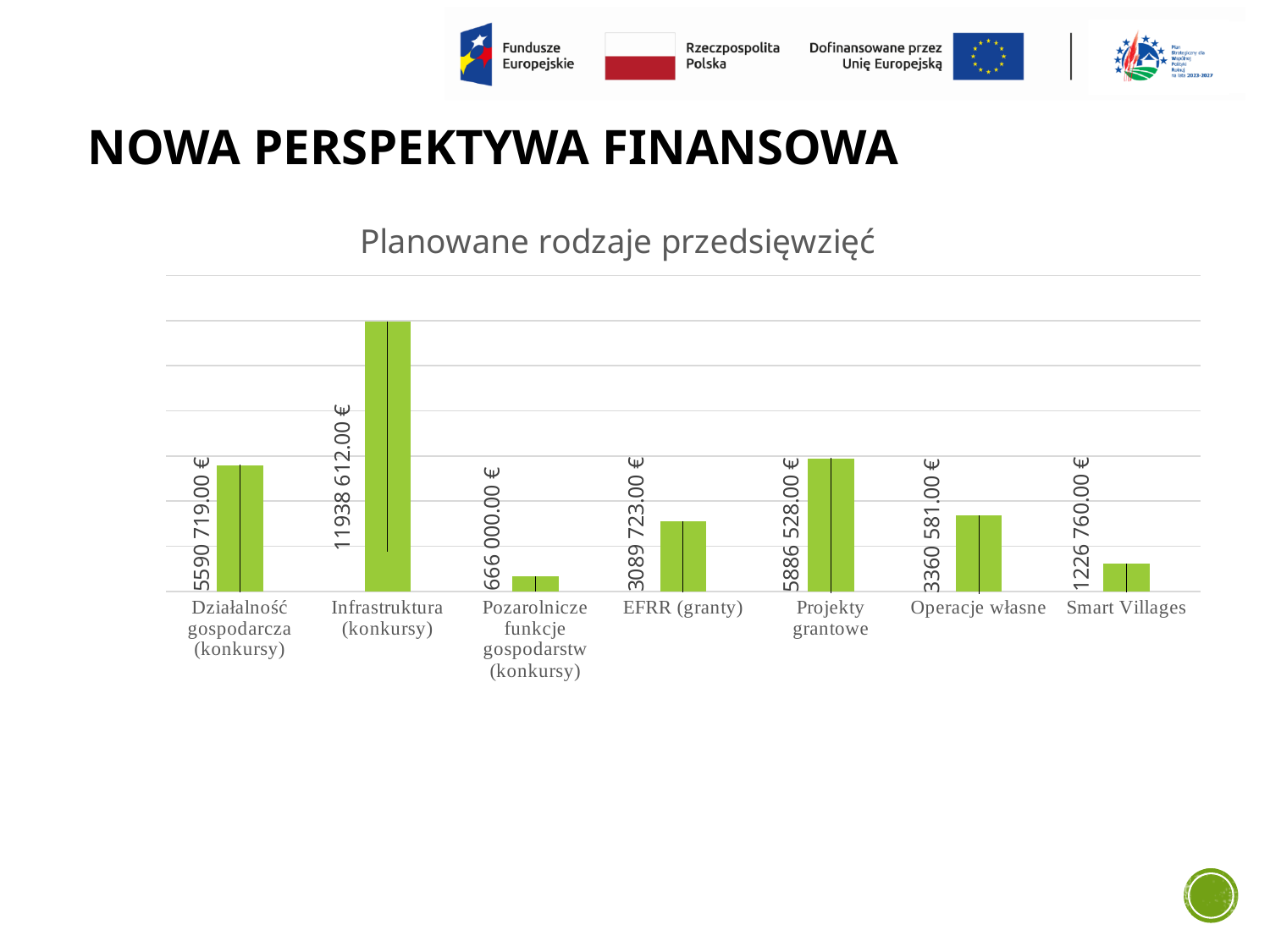
Which category has the lowest value? Pozarolnicze funkcje gospodarstw (konkursy) What is the value for Operacje własne? 3360 581.00 € Which is larger, the value for Projekty grantowe or the value for Działalność gospodarcza (konkursy)? Projekty grantowe What type of chart is shown on the slide? bar chart What is the title of the chart? Planowane rodzaje przedsięwzięć What is the value for Pozarolnicze funkcje gospodarstw (konkursy)? 666 000.00 € Which category has the highest value? Infrastruktura (konkursy) What is the difference between the values for Infrastruktura (konkursy) and Działalność gospodarcza (konkursy)? 6347 893.00 € What is the difference between the values for Operacje własne and EFRR (granty)? 270 858.00 € What is the value for Smart Villages? 1226 760.00 € How many categories are shown in the chart? 7 What is the value for Infrastruktura (konkursy)? 11938 612.00 €